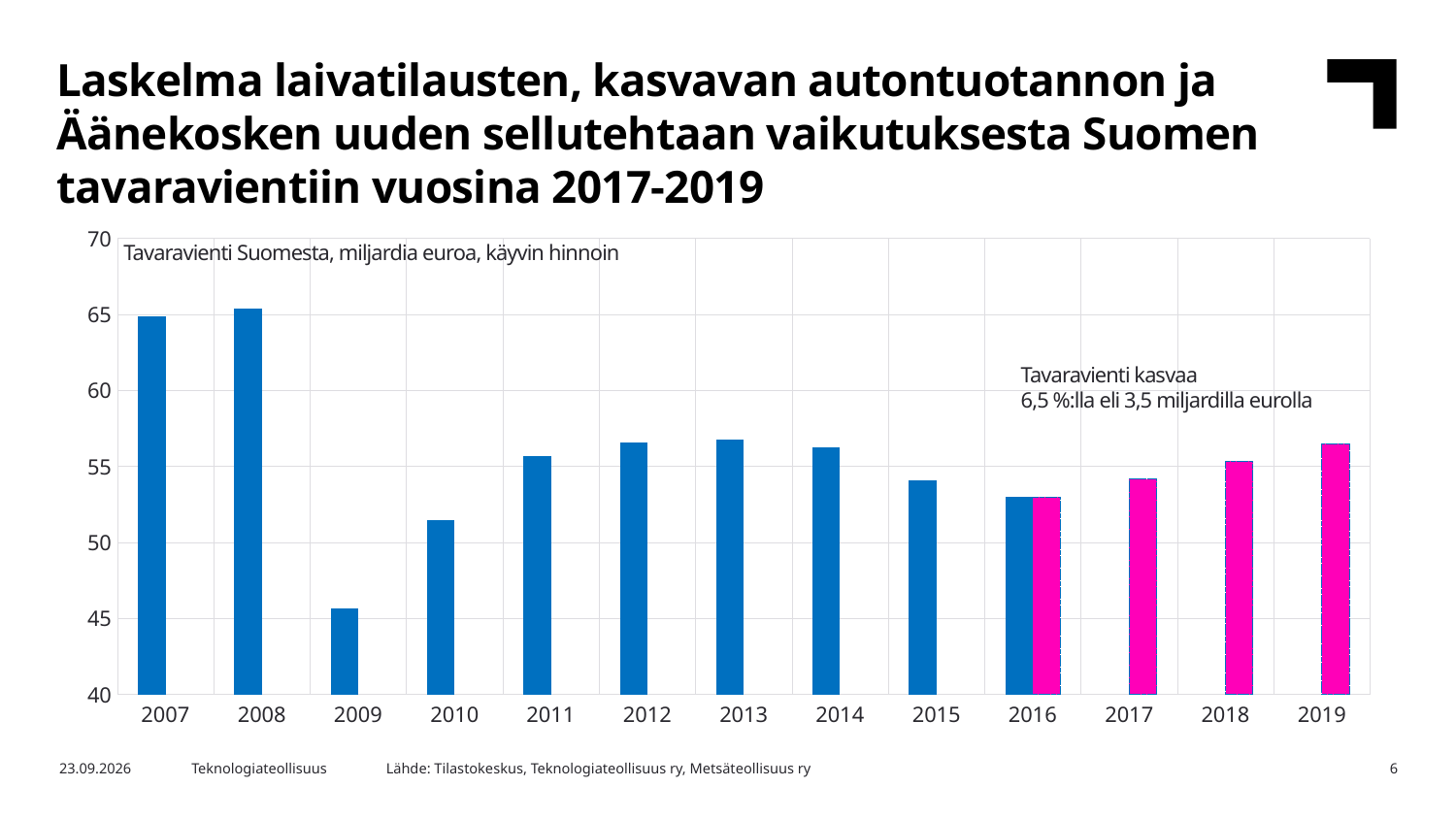
According to the annotation on the chart, by how many percent does goods export grow? 6,5 % Is the value for 2009 greater or less than 50? less Is the value for 2016 greater or less than 55? less What kind of chart is shown on the slide? Bar chart Which year has the lowest value in the chart? 2009 Which year has the highest value in the chart? 2008 Do the values rise or fall from 2016 to 2019? rise Is the value for 2019 greater or less than 55? greater Which is larger, the value for 2013 or the value for 2015? 2013 What unit does the chart's subtitle say the values are in? miljardia euroa, käyvin hinnoin How many years are shown on the x axis of the chart? 13